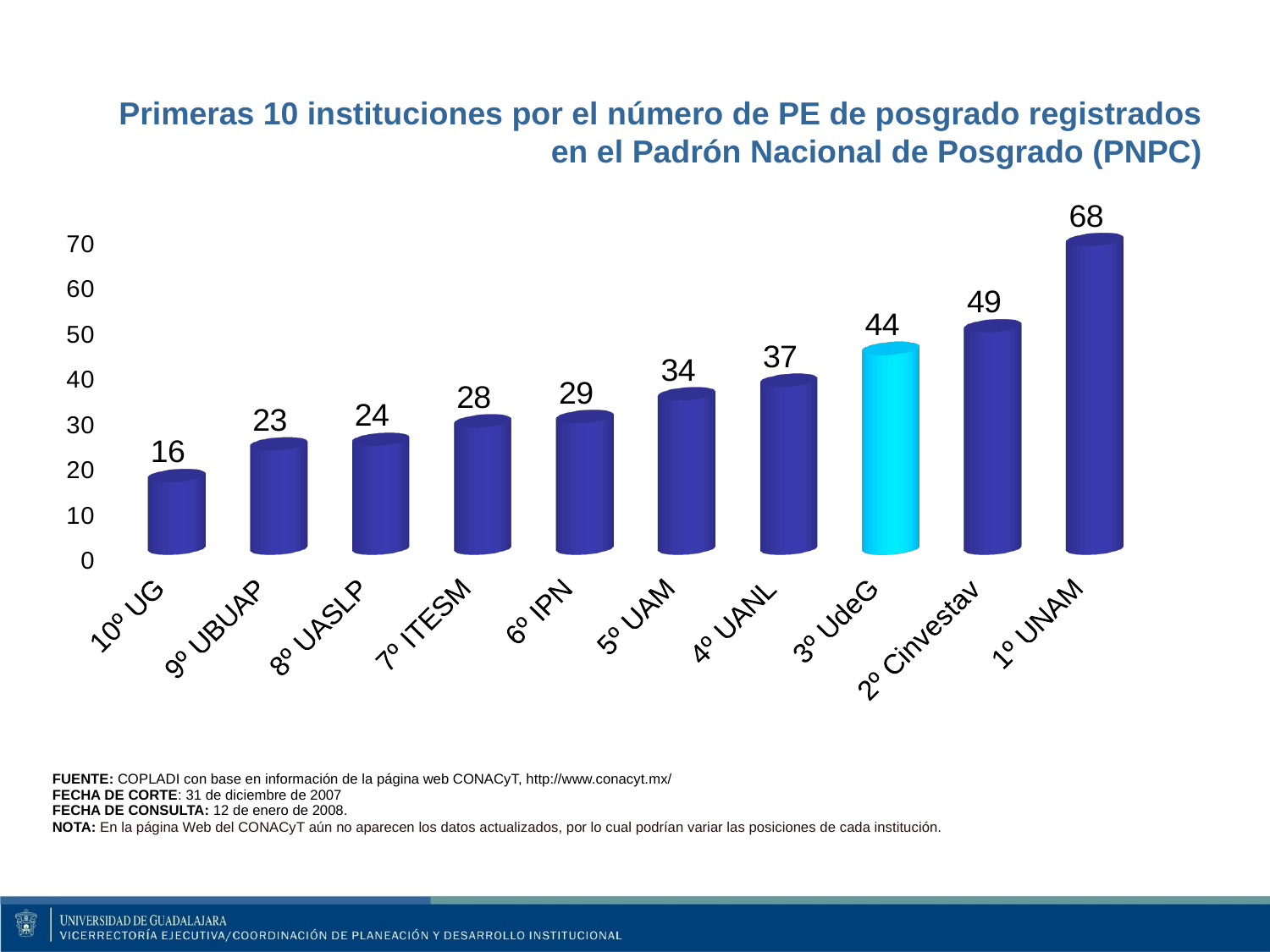
What is the value for 2º Cinvestav? 49 Which is larger, the value for 5º UAM or the value for 6º IPN? 5º UAM Which institution has the lowest value? 10º UG How many institutions are shown in the chart? 10 What kind of chart is shown on the slide? bar chart What is the value for 7º ITESM? 28 Which institution has the highest value? 1º UNAM What is the difference between the values for 1º UNAM and 2º Cinvestav? 19 Is the value for 9º UBUAP greater or less than 20? greater What is the difference between the values for 3º UdeG and 4º UANL? 7 Do the values rise or fall from left to right along the x axis? rise What is the value for 3º UdeG? 44